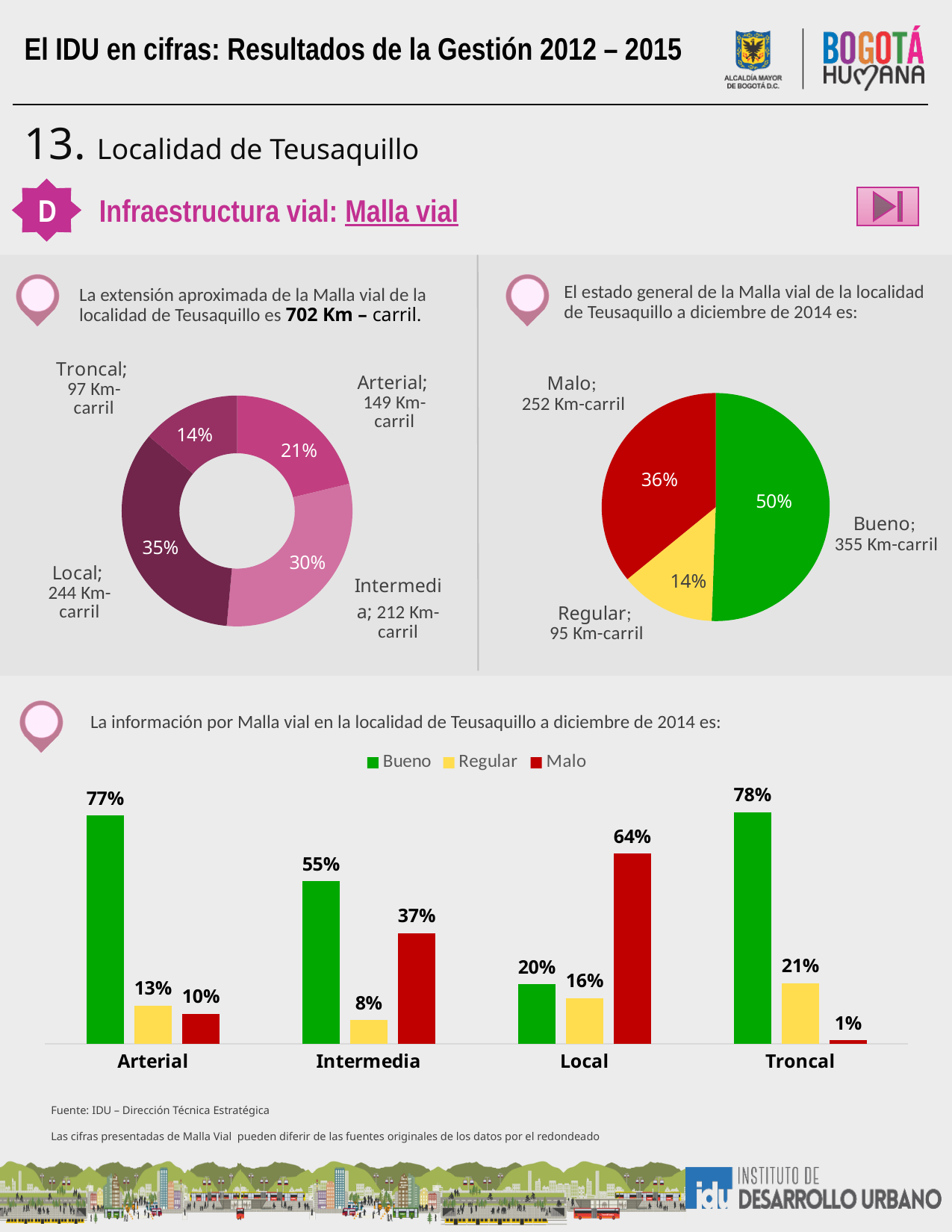
In the pie chart on the right, how many Km-carril are in the Malo category? 252 Km-carril In the donut chart on the left, how many categories are shown? 4 In the bar chart at the bottom, what is the difference between the Malo value for Local and the Malo value for Intermedia? 27% In the bar chart at the bottom, how many series does the legend list? 3 In the bar chart at the bottom, what is the Malo value for Local? 64% In the donut chart on the left, how many Km-carril does the Local category have? 244 Km-carril In the donut chart on the left, which category has the largest share? Local In the pie chart on the right, which category has the smallest share? Regular In the bar chart at the bottom, which is larger: the Regular value for Troncal or the Regular value for Arterial? Troncal In the pie chart on the right, what share does Bueno represent? 50% In the donut chart on the left, what share does Intermedia represent? 30% In the bar chart at the bottom, which category has the highest Bueno value? Troncal